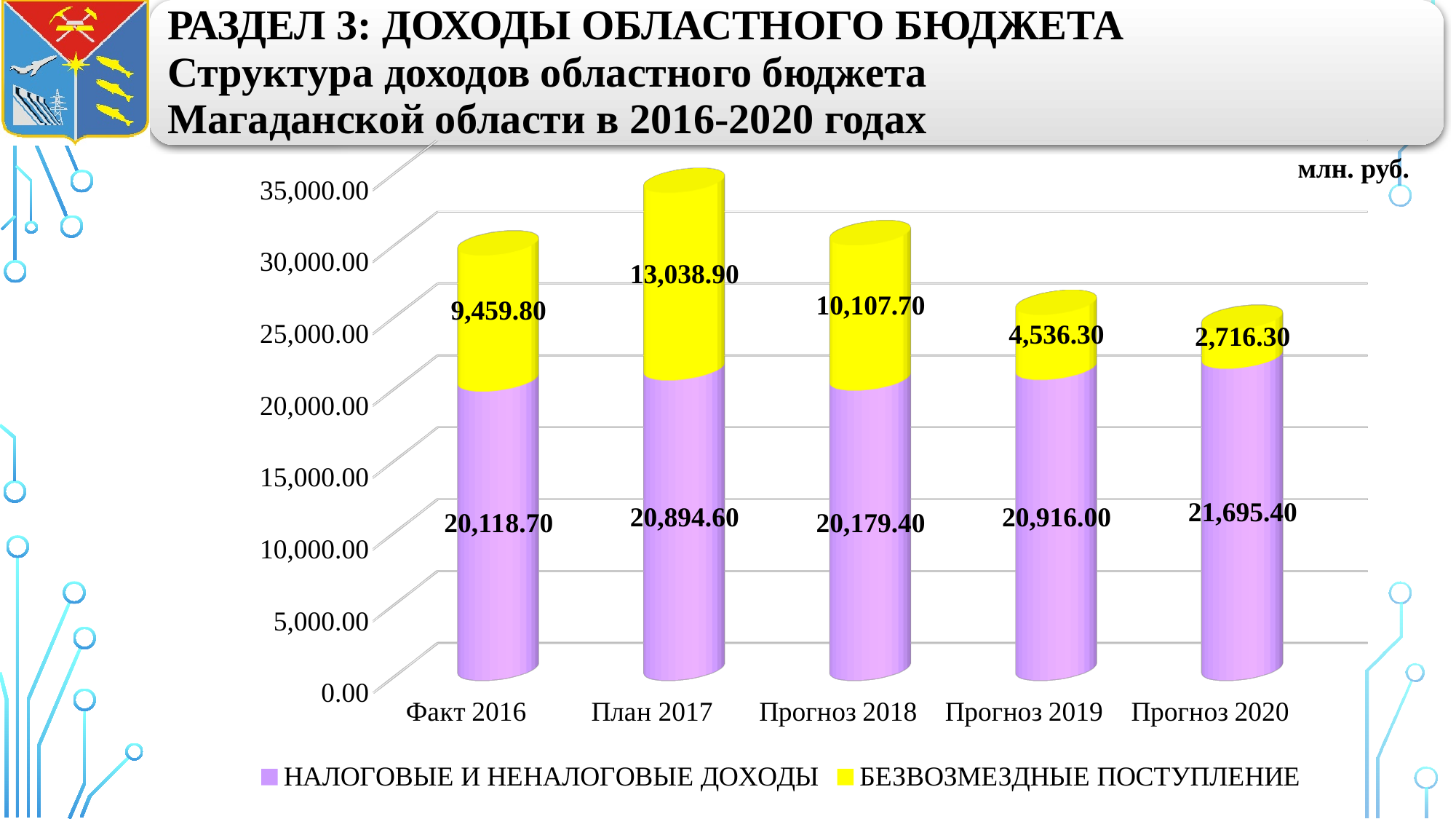
Which category has the highest value for БЕЗВОЗМЕЗДНЫЕ ПОСТУПЛЕНИЕ? План 2017 What kind of chart is shown on the slide? Stacked bar chart What is the total of the stacked bar for План 2017? 33,933.50 How many series does the legend list? 2 What is the value of БЕЗВОЗМЕЗДНЫЕ ПОСТУПЛЕНИЕ for Прогноз 2020? 2,716.30 What is the value of НАЛОГОВЫЕ И НЕНАЛОГОВЫЕ ДОХОДЫ for Факт 2016? 20,118.70 Which category has the lowest value for НАЛОГОВЫЕ И НЕНАЛОГОВЫЕ ДОХОДЫ? Факт 2016 Which is larger: НАЛОГОВЫЕ И НЕНАЛОГОВЫЕ ДОХОДЫ for Прогноз 2020 or for Прогноз 2019? Прогноз 2020 What is the value of БЕЗВОЗМЕЗДНЫЕ ПОСТУПЛЕНИЕ for План 2017? 13,038.90 How many categories are shown on the x axis? 5 What is the difference between the БЕЗВОЗМЕЗДНЫЕ ПОСТУПЛЕНИЕ values for План 2017 and Факт 2016? 3,579.10 What is the total of the stacked bar for Прогноз 2020? 24,411.70